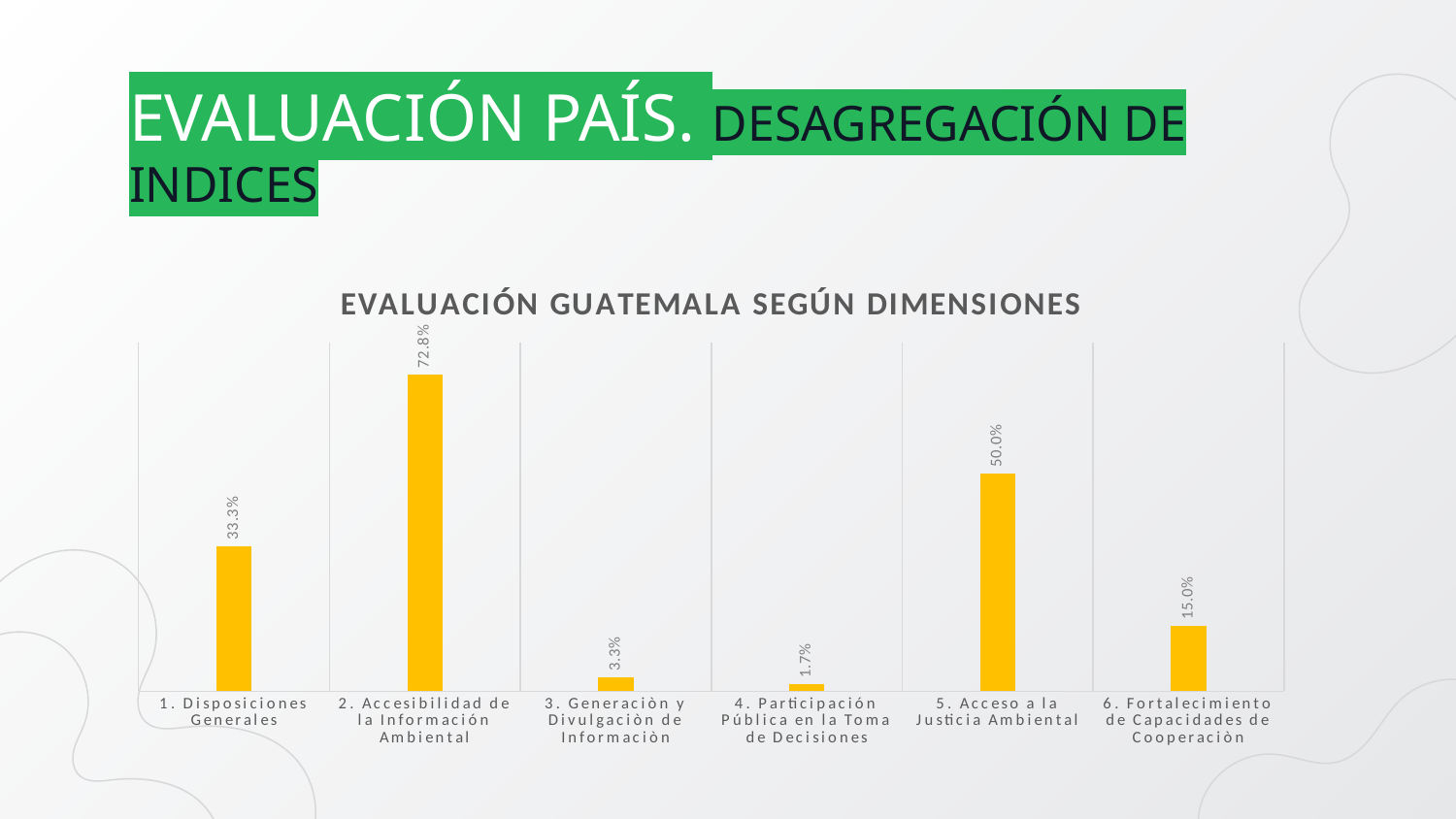
Which is larger, the value for '1. Disposiciones Generales' or '6. Fortalecimiento de Capacidades de Cooperaciòn'? 1. Disposiciones Generales What is the value for '1. Disposiciones Generales'? 33.3% What is the value for '6. Fortalecimiento de Capacidades de Cooperaciòn'? 15.0% What kind of chart is shown on the slide? Bar chart Which dimension has the highest value? 2. Accesibilidad de la Información Ambiental Which dimension has the lowest value? 4. Participación Pública en la Toma de Decisiones What is the difference between the values for '2. Accesibilidad de la Información Ambiental' and '5. Acceso a la Justicia Ambiental'? 22.8% How many dimensions are shown in the chart? 6 What is the title of the chart? EVALUACIÓN GUATEMALA SEGÚN DIMENSIONES What is the value for '5. Acceso a la Justicia Ambiental'? 50.0% What is the value for '2. Accesibilidad de la Información Ambiental'? 72.8% What is the value for '3. Generaciòn y Divulgaciòn de Informaciòn'? 3.3%